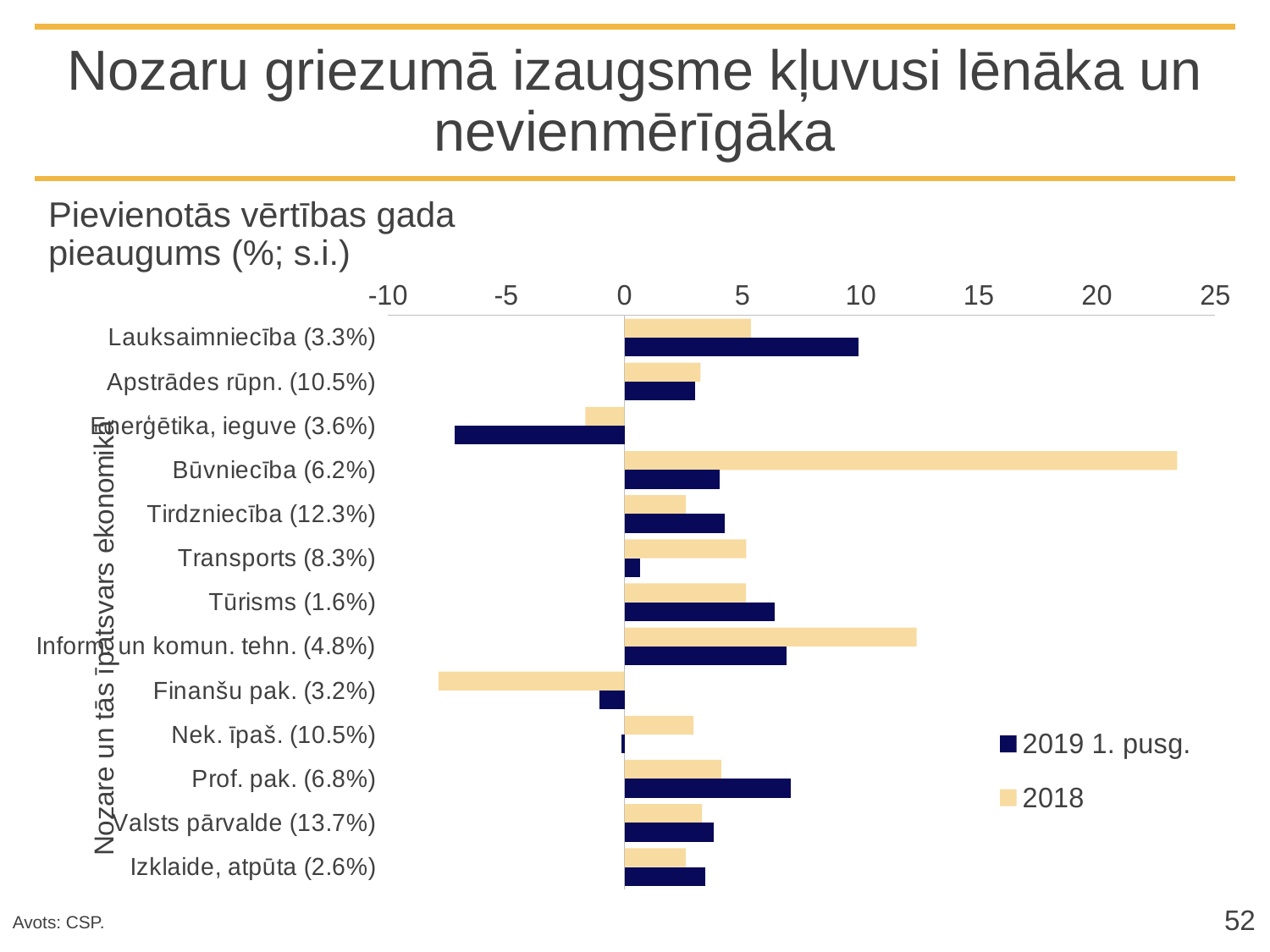
How many sectors (categories) are plotted on the chart? 13 Which sector has the highest value for the 2018 series? Būvniecība (6.2%) For Transports (8.3%), which series has the larger value, 2018 or 2019 1. pusg.? 2018 What kind of chart is shown on the slide? bar chart Is the 2018 value for Būvniecība (6.2%) greater or less than 20? greater Which sector has the lowest value for the 2019 1. pusg. series? Enerģētika, ieguve (3.6%) How many series does the legend list? 2 Is the 2018 value for Inform. un komun. tehn. (4.8%) greater or less than 10? greater Which sector has the highest value for the 2019 1. pusg. series? Lauksaimniecība (3.3%) What is the highest value shown on the horizontal axis of the chart? 25 For Lauksaimniecība (3.3%), which series has the larger value, 2019 1. pusg. or 2018? 2019 1. pusg. Which sector has the lowest value for the 2018 series? Finanšu pak. (3.2%)